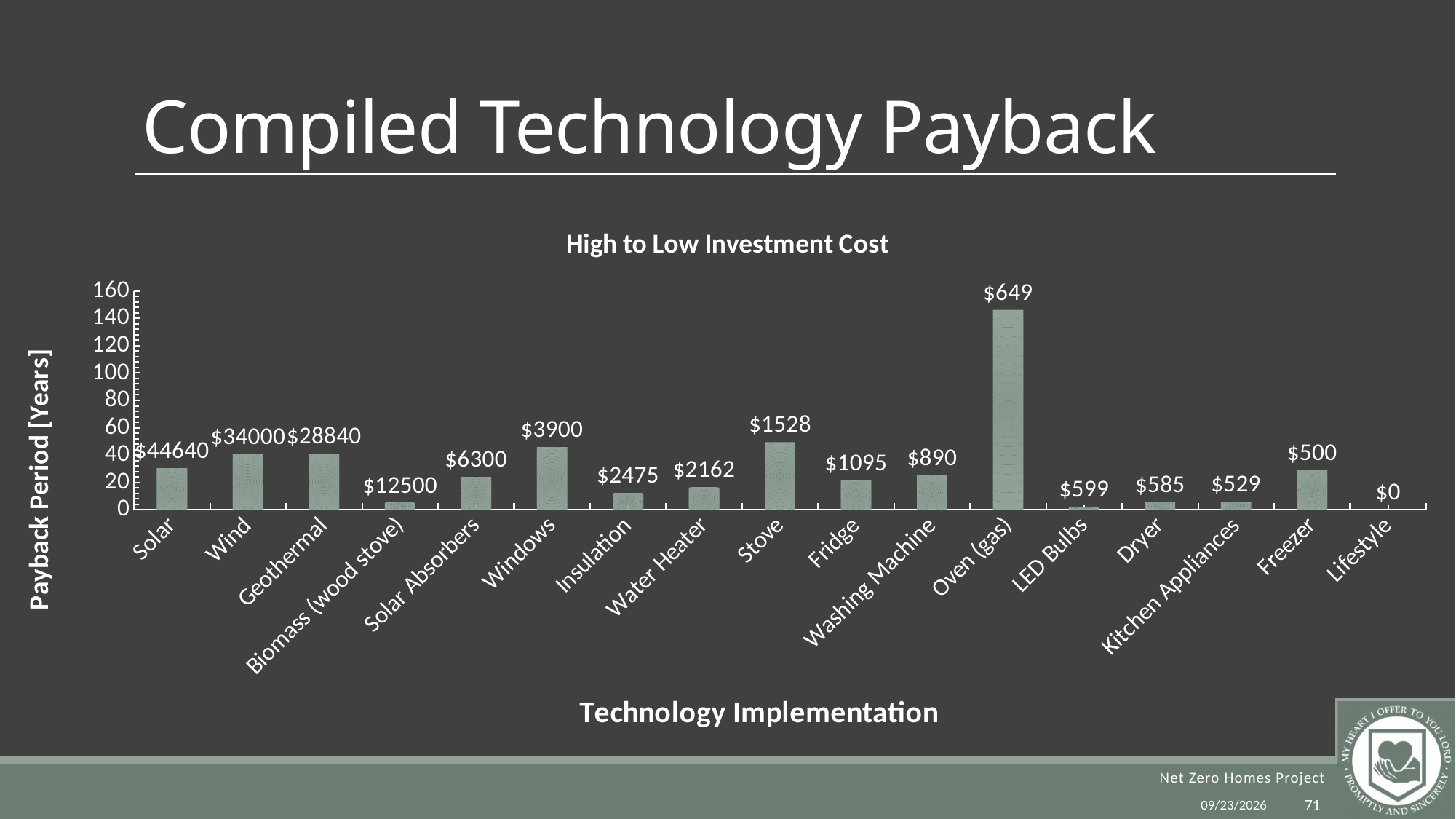
What investment cost label is printed above the Wind bar? $34000 Which technology has the highest payback period? Oven (gas) What investment cost label is printed above the Oven (gas) bar? $649 Is the payback period for Solar greater or less than 40 years? less What is the title of the chart? High to Low Investment Cost What kind of chart is shown on the slide? bar chart Which technology has the lowest payback period? Lifestyle How many technology categories are shown on the x axis? 17 Is the payback period for Oven (gas) greater or less than 120 years? greater Is the payback period for Biomass (wood stove) greater or less than 20 years? less What is the label of the vertical axis? Payback Period [Years] Which has a longer payback period, Stove or Fridge? Stove